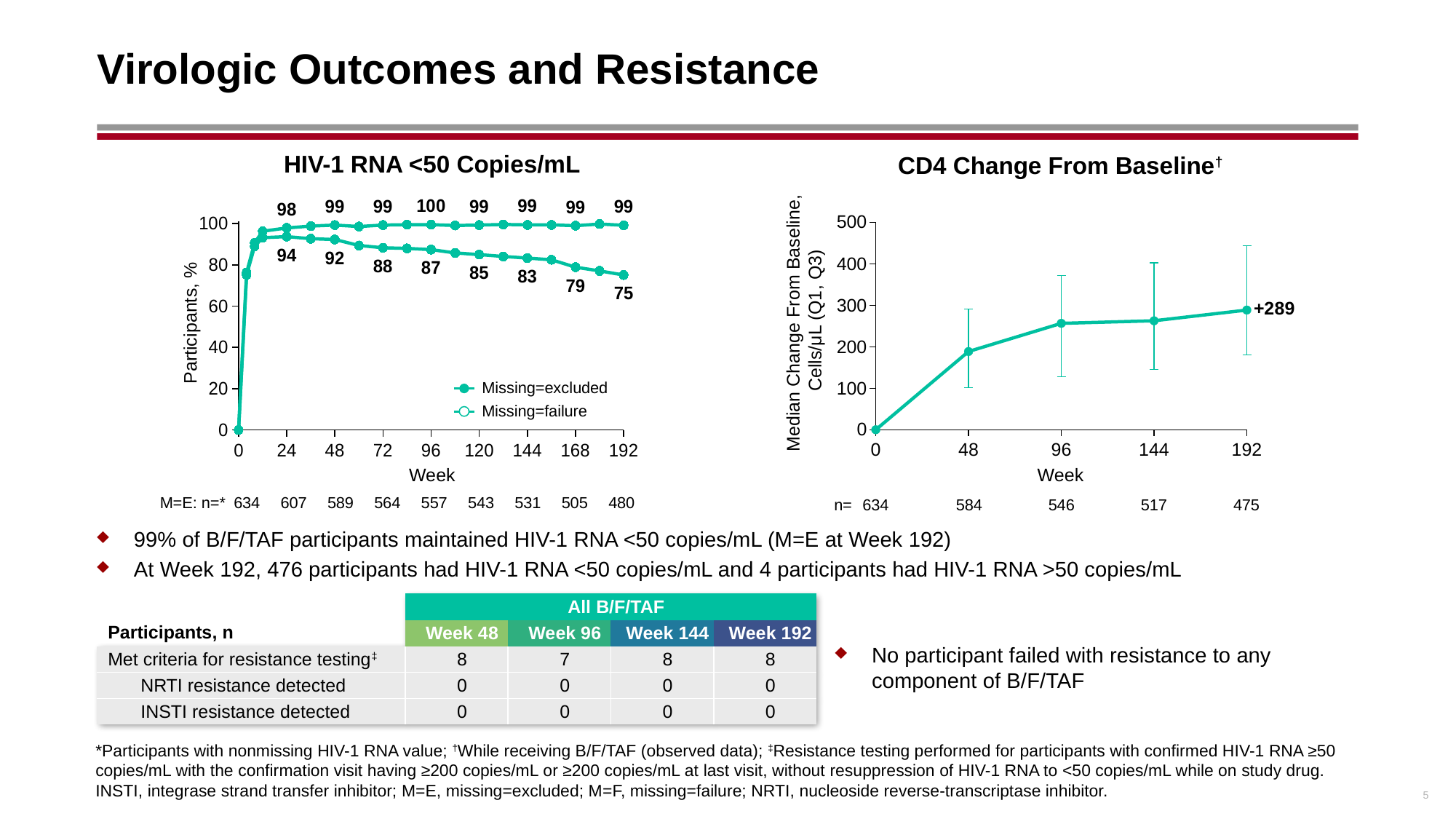
In the CD4 Change From Baseline chart, what is the labeled value at Week 192? +289 In the HIV-1 RNA <50 Copies/mL chart, what is the value for Missing=excluded at Week 96? 100 What kind of chart is the CD4 Change From Baseline chart? line chart In the HIV-1 RNA <50 Copies/mL chart, what is the value for Missing=failure at Week 48? 92 In the HIV-1 RNA <50 Copies/mL chart, what is the value for Missing=failure at Week 192? 75 In the HIV-1 RNA <50 Copies/mL chart, at which week is the Missing=failure value lowest? Week 192 In the HIV-1 RNA <50 Copies/mL chart, which series has the higher value at Week 168? Missing=excluded In the HIV-1 RNA <50 Copies/mL chart, what is the value for Missing=excluded at Week 192? 99 In the CD4 Change From Baseline chart, is the median value at Week 96 greater or less than 200? greater In the HIV-1 RNA <50 Copies/mL chart, does the Missing=failure line rise or fall from Week 24 to Week 192? fall In the HIV-1 RNA <50 Copies/mL chart, what is the difference between the Missing=excluded and Missing=failure values at Week 192? 24 How many series does the legend of the HIV-1 RNA <50 Copies/mL chart list? 2